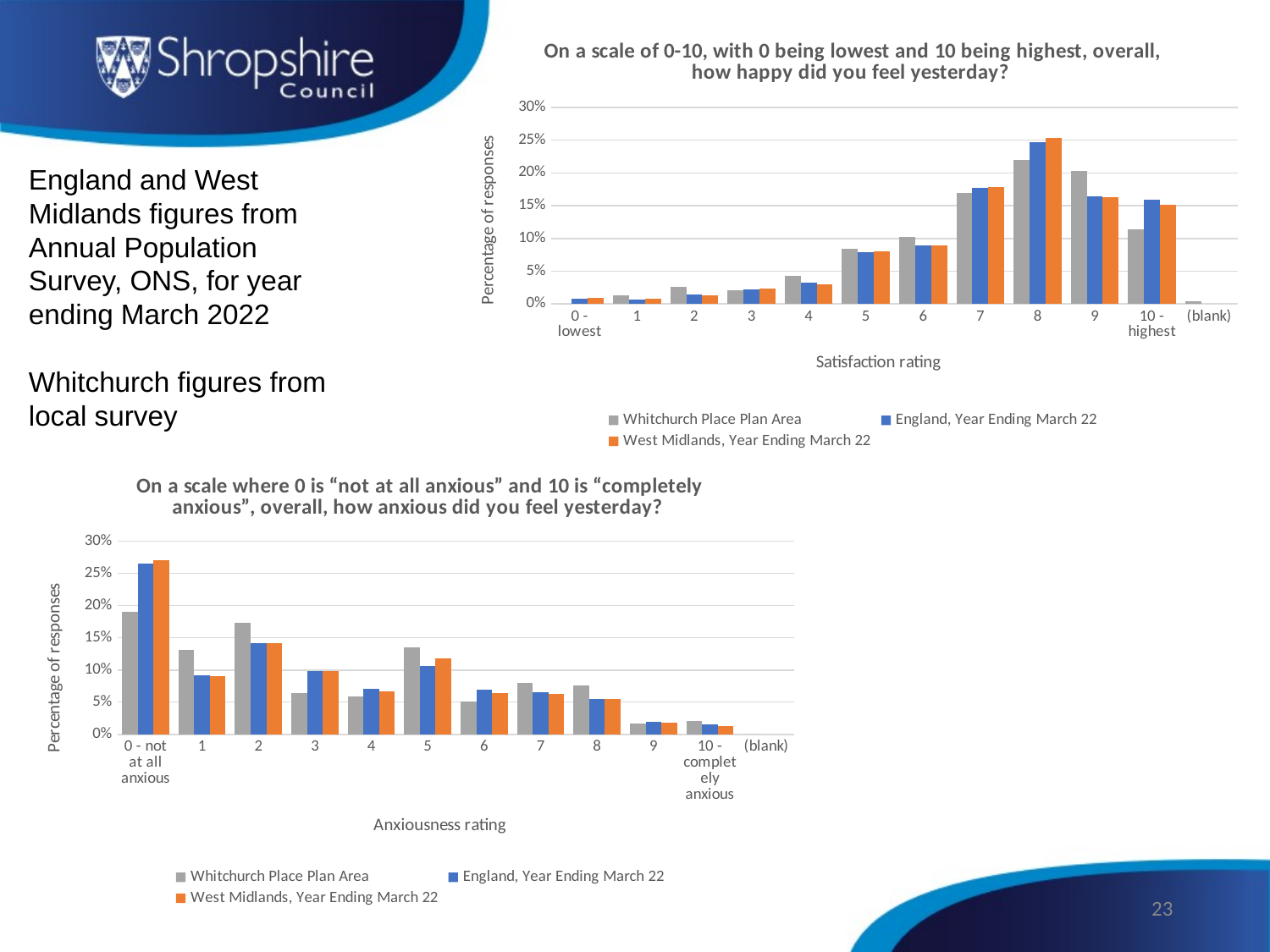
In the chart titled 'how happy did you feel yesterday?', how many categories are shown on the x axis? 12 In the chart titled 'how happy did you feel yesterday?', what kind of chart is shown? Bar chart In the chart titled 'how anxious did you feel yesterday?', is the value for West Midlands, Year Ending March 22 at '0 - not at all anxious' greater or less than 25%? greater In the chart titled 'how happy did you feel yesterday?', is the value for England, Year Ending March 22 at rating 7 greater or less than 15%? greater In the chart titled 'how happy did you feel yesterday?', at rating 10 - highest, which is larger: Whitchurch Place Plan Area or England, Year Ending March 22? England, Year Ending March 22 In the chart titled 'how happy did you feel yesterday?', is the value for Whitchurch Place Plan Area at rating 8 greater or less than 20%? greater In the chart titled 'how happy did you feel yesterday?', how many series does the legend list? 3 In the chart titled 'how anxious did you feel yesterday?', what is the label of the x axis? Anxiousness rating In the chart titled 'how anxious did you feel yesterday?', which anxiousness rating has the highest value for England, Year Ending March 22? 0 - not at all anxious In the chart titled 'how happy did you feel yesterday?', which satisfaction rating has the highest value for Whitchurch Place Plan Area? 8 In the chart titled 'how anxious did you feel yesterday?', at rating 1, which is larger: Whitchurch Place Plan Area or England, Year Ending March 22? Whitchurch Place Plan Area